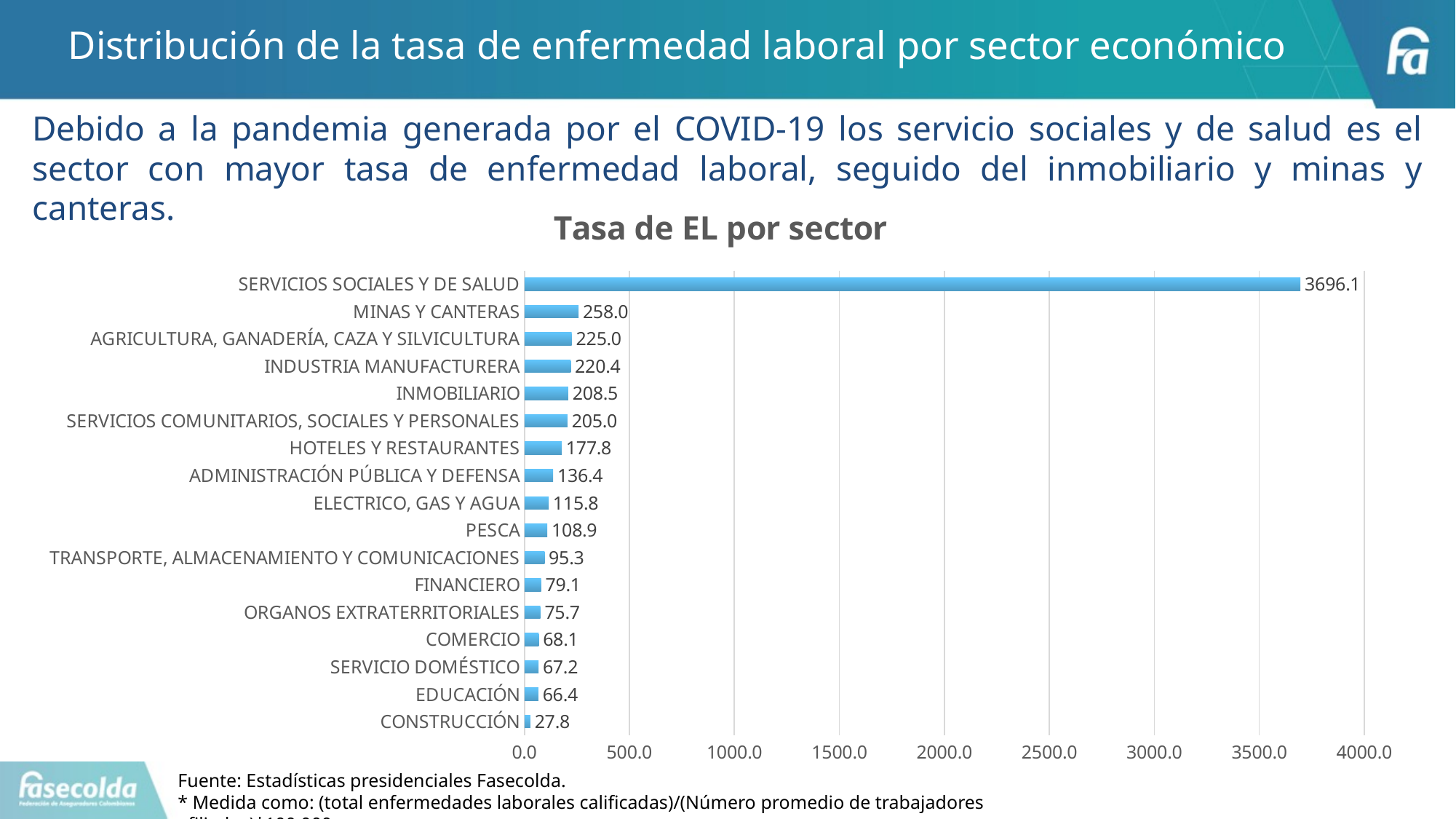
What is the difference between the values for MINAS Y CANTERAS and INMOBILIARIO? 49.5 What is the difference between the values for EDUCACIÓN and CONSTRUCCIÓN? 38.6 Which is larger, the value for PESCA or the value for FINANCIERO? PESCA Is the value for SERVICIOS SOCIALES Y DE SALUD greater or less than 3500.0? greater What is the value for SERVICIOS SOCIALES Y DE SALUD? 3696.1 Which sector has the lowest rate? CONSTRUCCIÓN Which sector has the highest rate? SERVICIOS SOCIALES Y DE SALUD What is the value for MINAS Y CANTERAS? 258.0 What is the title of the chart? Tasa de EL por sector How many sectors are shown in the chart? 17 What kind of chart is shown on the slide? bar chart What is the value for HOTELES Y RESTAURANTES? 177.8